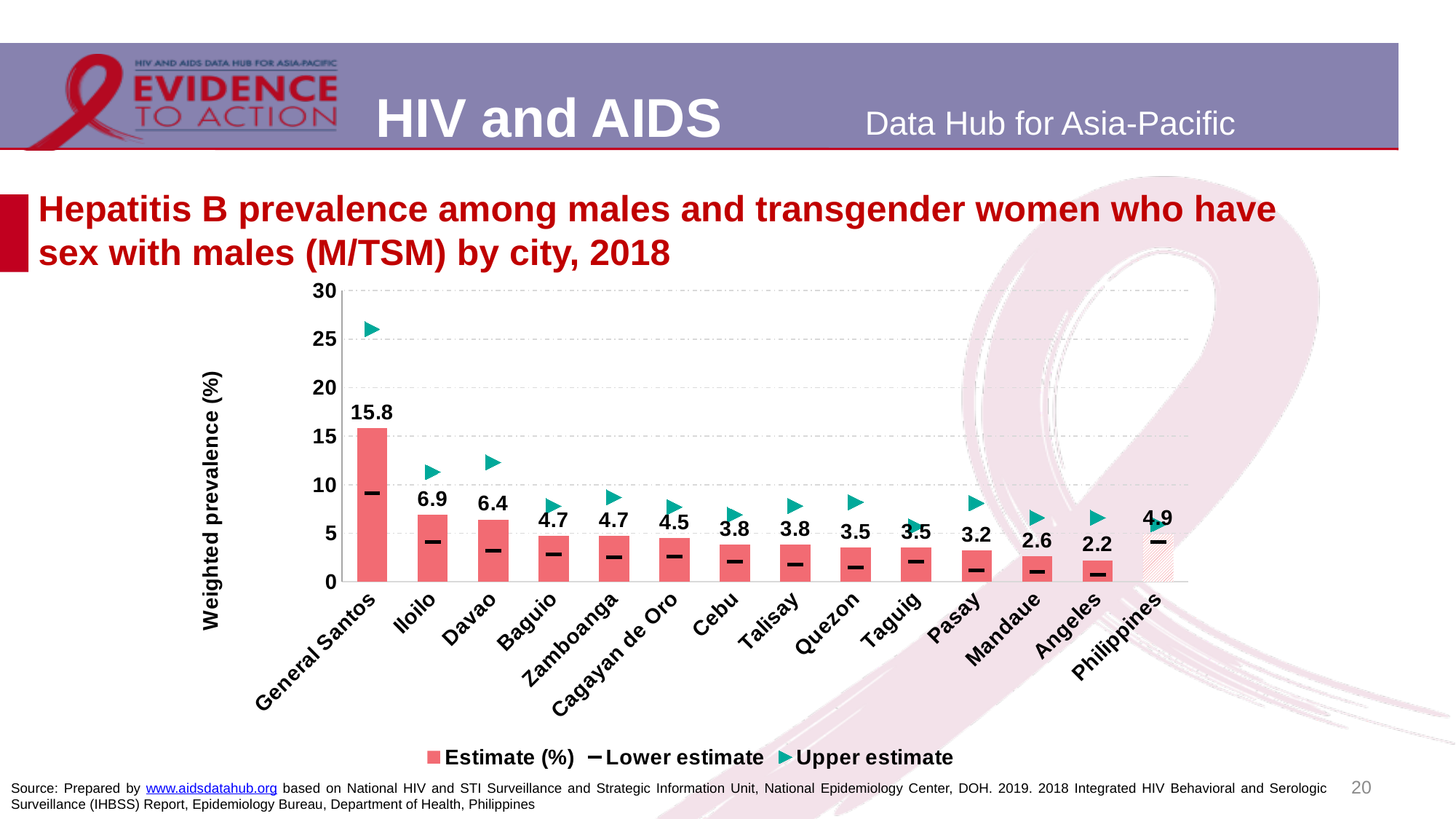
Which city has the lowest estimated Hepatitis B prevalence? Angeles How many categories are shown on the x axis? 14 Which has a higher estimated prevalence, Davao or Pasay? Davao Which city has the highest estimated Hepatitis B prevalence? General Santos What is the difference between the estimates for General Santos and Iloilo? 8.9 What is the estimated Hepatitis B prevalence for General Santos? 15.8 What is the label of the y axis? Weighted prevalence (%) Is the upper estimate for Davao greater or less than 10? greater What is the estimated Hepatitis B prevalence for Cagayan de Oro? 4.5 What kind of chart is shown on the slide? Bar chart How many series does the legend list? 3 What is the estimated Hepatitis B prevalence for the Philippines overall? 4.9